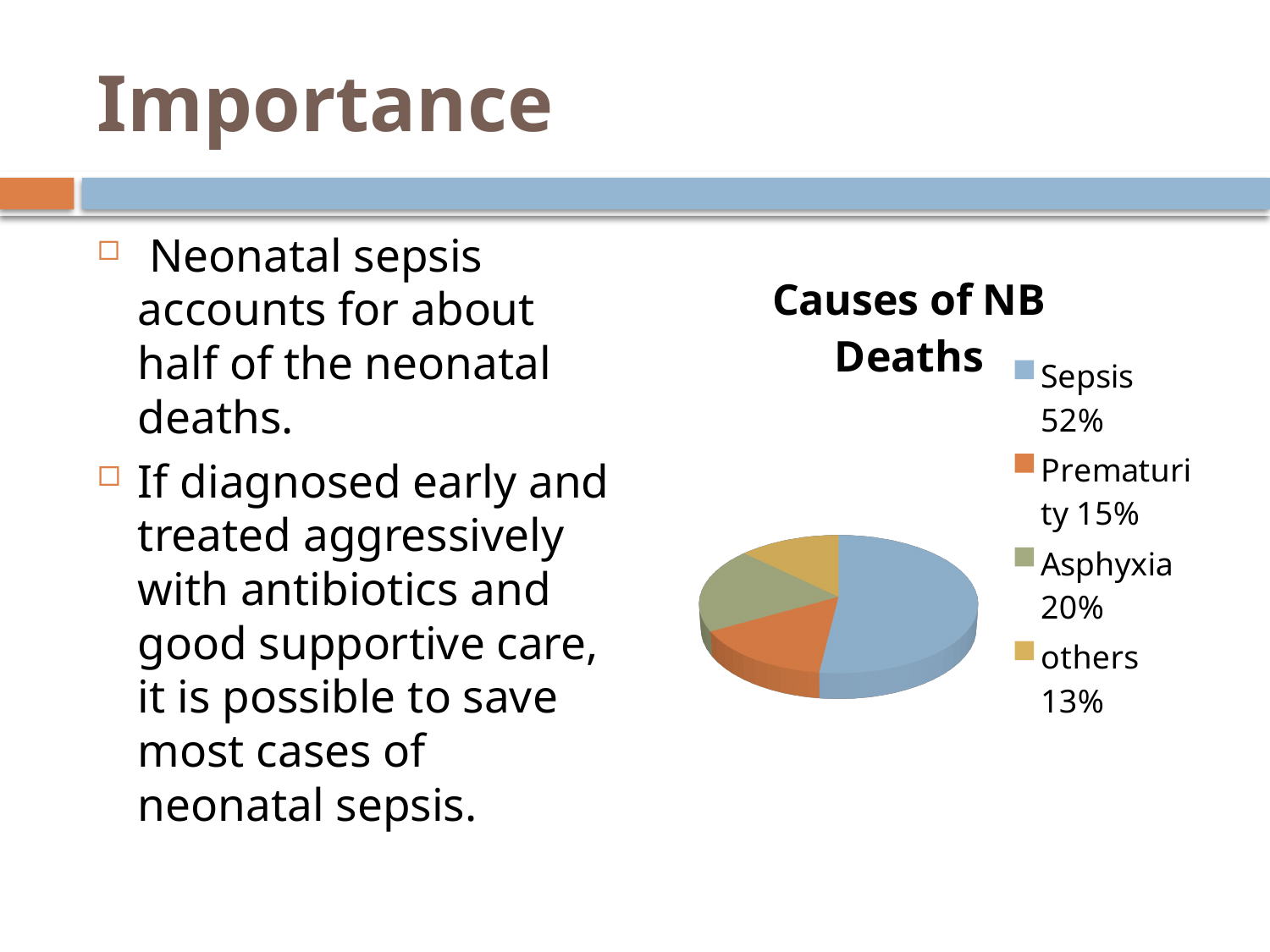
What share of NB deaths is attributed to Prematurity? 15% What colour is the Sepsis slice in the pie chart? blue What kind of chart is shown on the slide? pie chart Which cause accounts for the largest share of NB deaths? Sepsis What is the title of the pie chart? Causes of NB Deaths How many categories does the pie chart show? 4 What share of NB deaths is attributed to Asphyxia? 20% Which is larger, the share for Asphyxia or the share for Prematurity? Asphyxia What is the difference in percentage points between Sepsis and Asphyxia? 32 What share of NB deaths is attributed to others? 13% What share of NB deaths is attributed to Sepsis? 52% Which cause accounts for the smallest share of NB deaths? others